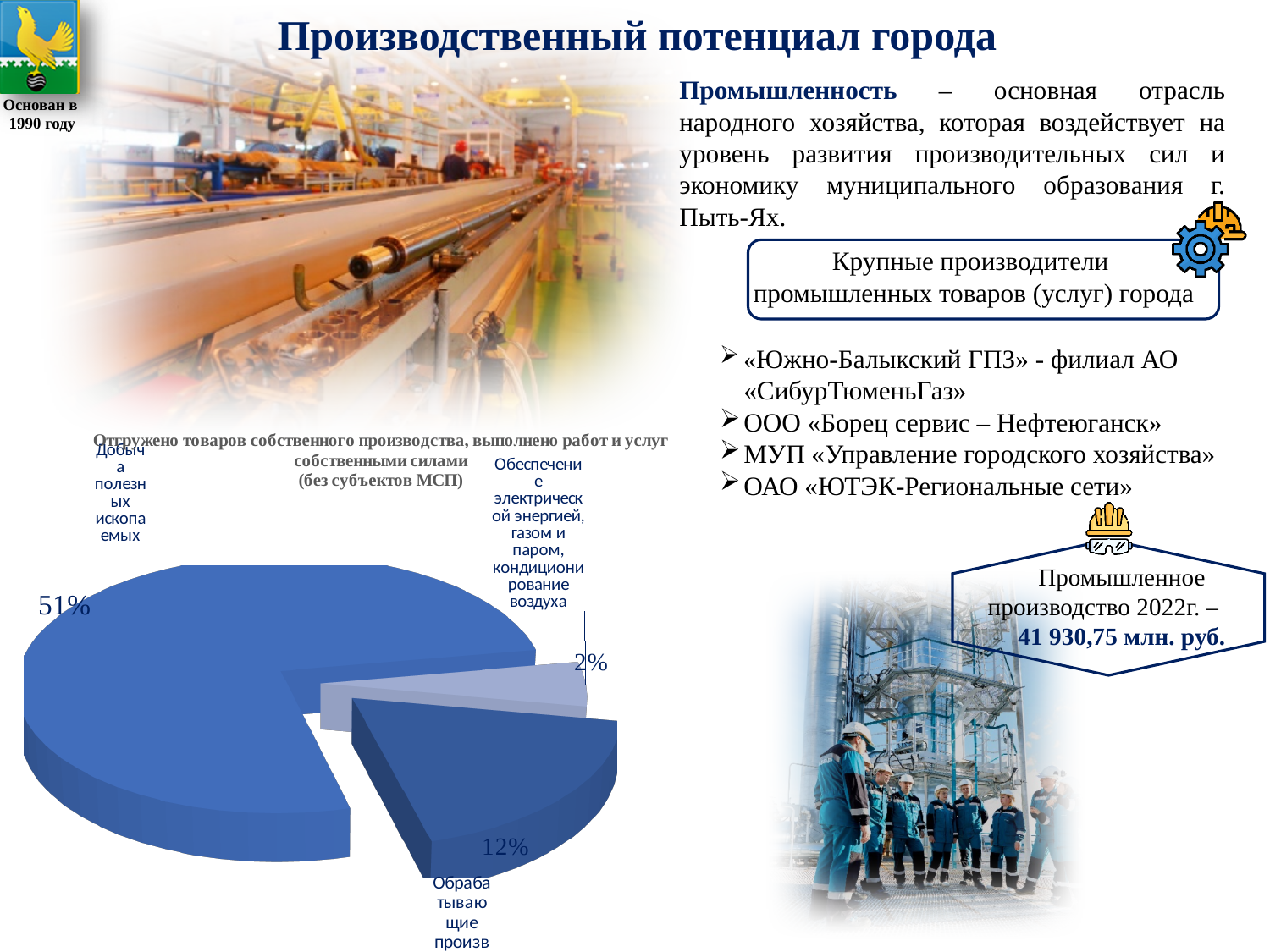
What kind of chart is shown on the slide? pie chart What is the title of the pie chart? Отгружено товаров собственного производства, выполнено работ и услуг собственными силами (без субъектов МСП) What share of the pie is labelled for "Обрабатывающие производства"? 12% How many slices does the pie chart have? 3 Which category has the largest slice of the pie? Добыча полезных ископаемых Which slice is larger: "Обрабатывающие производства" or "Обеспечение электрической энергией, газом и паром, кондиционирование воздуха"? Обрабатывающие производства What share of the pie is labelled for "Добыча полезных ископаемых"? 51% Which category has the smallest slice of the pie? Обеспечение электрической энергией, газом и паром, кондиционирование воздуха Is the "Добыча полезных ископаемых" slice greater or less than 50% of the pie? greater What is the difference in percentage points between the "Добыча полезных ископаемых" slice and the "Обрабатывающие производства" slice? 39 What share of the pie is labelled for "Обеспечение электрической энергией, газом и паром, кондиционирование воздуха"? 2%